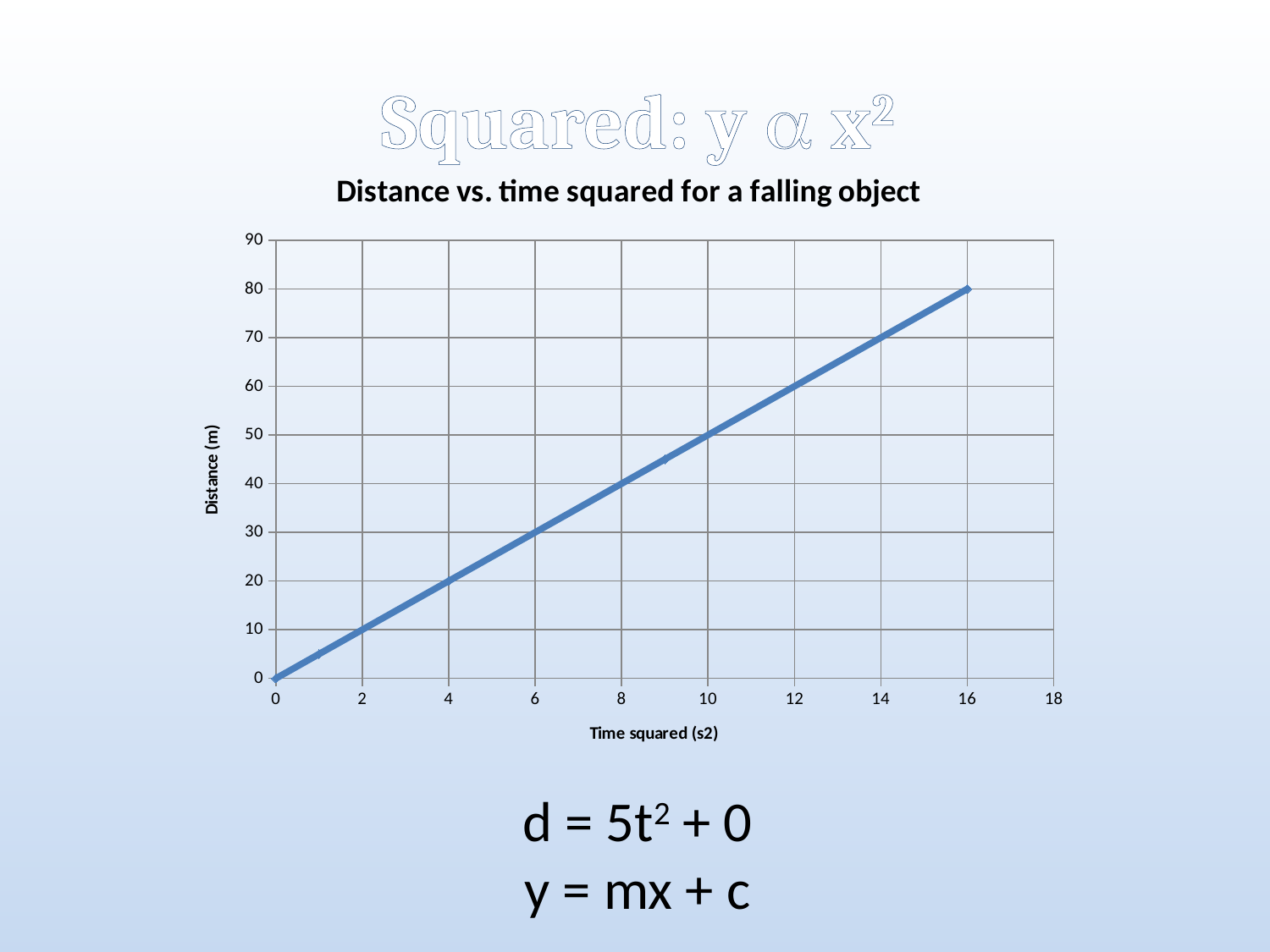
What kind of chart is shown on the slide? line chart Is the distance at time squared 6 greater or less than 40? less Does the distance rise or fall as time squared increases along the x axis? rise What is the title of the chart? Distance vs. time squared for a falling object What is the label of the vertical axis? Distance (m) What is the distance when time squared is 4? 20 What is the distance when time squared is 0? 0 Is the distance at time squared 12 greater or less than 50? greater What is the highest distance value plotted on the chart? 80 What is the lowest distance value plotted on the chart? 0 What is the distance when time squared is 16? 80 Which has the larger distance: time squared 4 or time squared 16? time squared 16